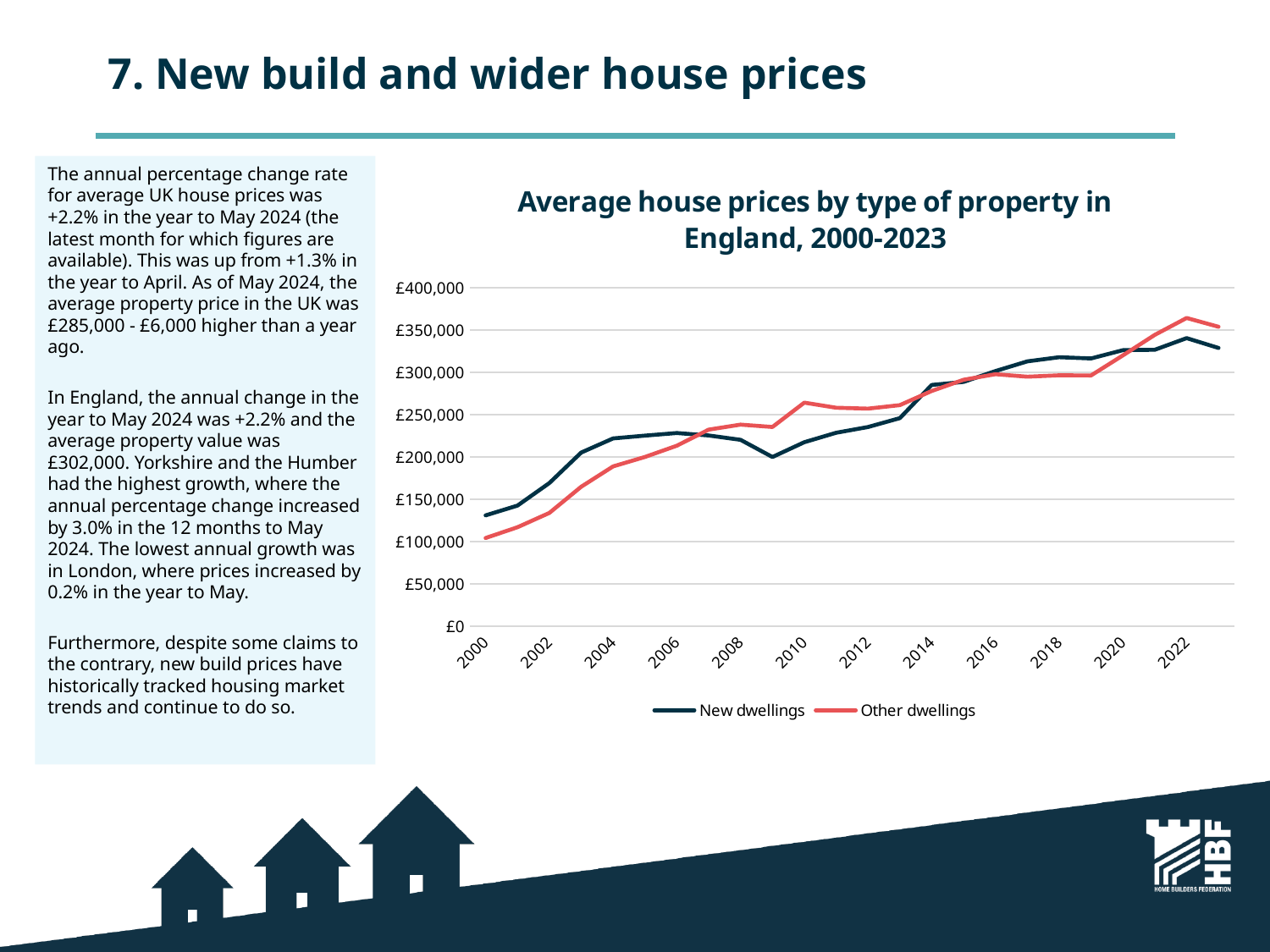
Is the value for Other dwellings in 2004 greater or less than £200,000? less What kind of chart is shown on the slide? Line chart Do the values for New dwellings generally rise or fall from 2000 to 2022? Rise In 2022, which series has the higher value, New dwellings or Other dwellings? Other dwellings How many year labels are shown on the x axis? 12 Is the value for Other dwellings in 2022 greater or less than £350,000? greater Which series is drawn in red? Other dwellings Is the value for Other dwellings in 2010 greater or less than £250,000? greater How many series does the legend list? 2 In 2004, which series has the higher value, New dwellings or Other dwellings? New dwellings What is the title of the chart? Average house prices by type of property in England, 2000-2023